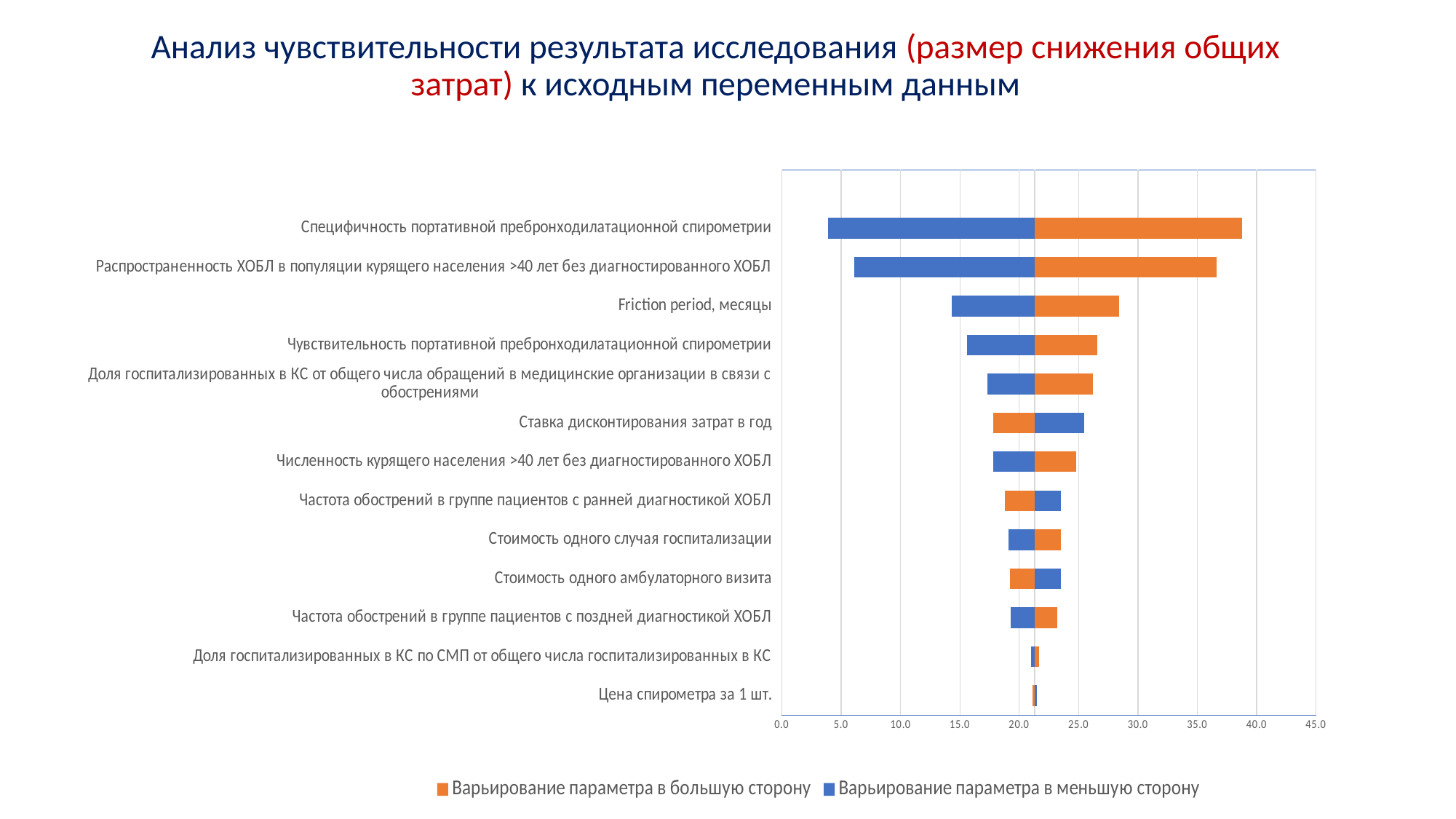
Is the left end of the blue bar for 'Специфичность портативной пребронходилатационной спирометрии' greater or less than 10.0? less Is the right end of the orange bar for 'Специфичность портативной пребронходилатационной спирометрии' greater or less than 35.0? greater Is the right end of the orange bar for 'Распространенность ХОБЛ в популяции курящего населения >40 лет без диагностированного ХОБЛ' greater or less than 35.0? greater How many categories (parameters) are listed on the vertical axis of the chart? 13 How many series does the chart legend list? 2 Do the total bar widths increase or decrease going from the top category to the bottom category? decrease Which bar is wider: 'Friction period, месяцы' or 'Стоимость одного случая госпитализации'? Friction period, месяцы What kind of chart is shown on the slide? bar chart Which category has the widest total bar in the chart? Специфичность портативной пребронходилатационной спирометрии Which category has the narrowest total bar in the chart? Цена спирометра за 1 шт. Which colour represents 'Варьирование параметра в меньшую сторону' in the legend? blue